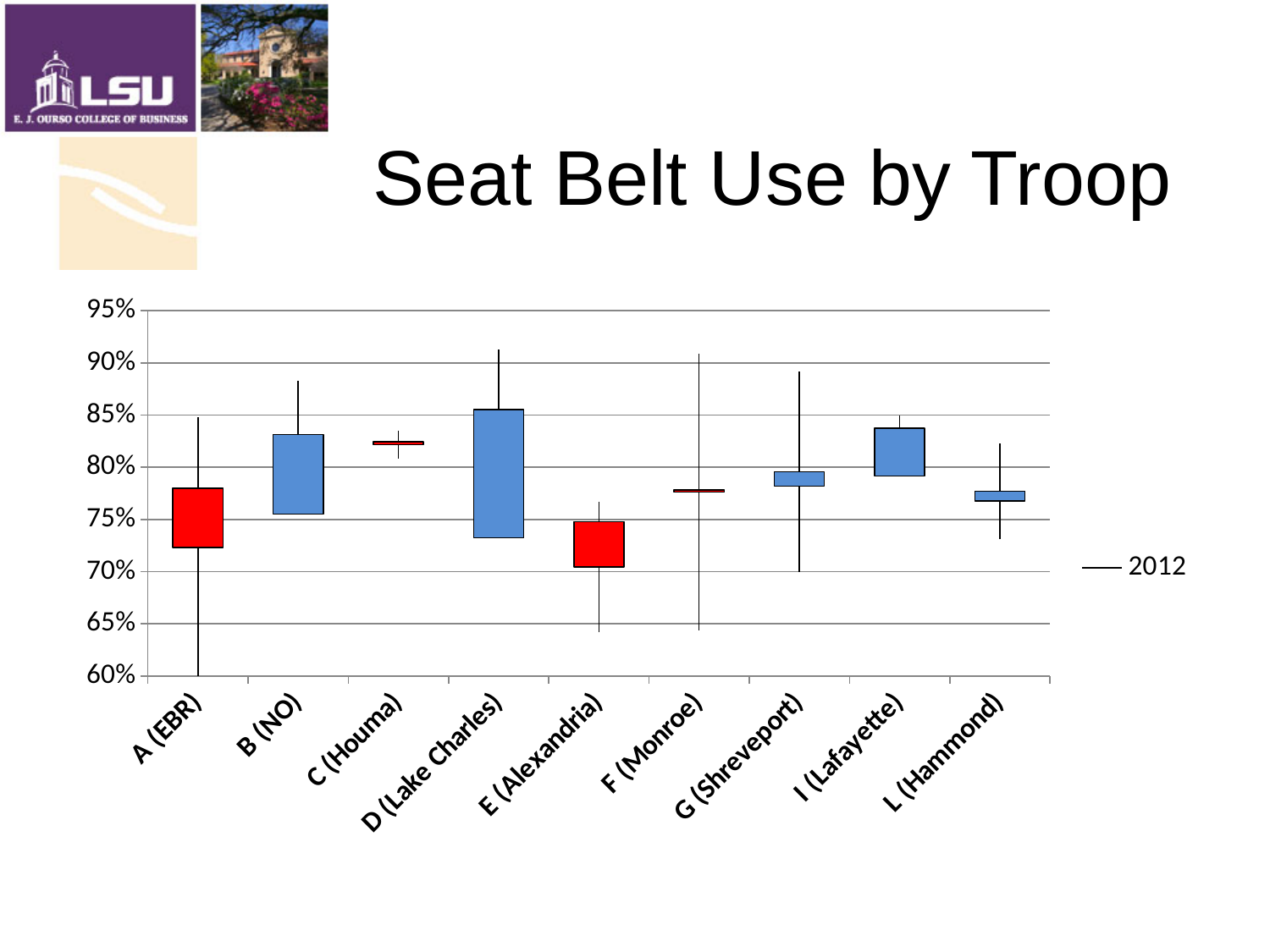
How many troops are shown along the x axis? 9 Which troop has the tallest box (widest range between box top and bottom)? D (Lake Charles) Is the lowest point of the line for A (EBR) greater or less than 65%? less Is the top of the box for E (Alexandria) greater or less than 80%? less Which troop has the taller box, D (Lake Charles) or C (Houma)? D (Lake Charles) What is the title of the chart? Seat Belt Use by Troop What year does the legend entry show? 2012 Is the bottom of the box for B (NO) greater or less than 70%? greater Which troop's lower line reaches the lowest value on the chart? A (EBR) What kind of chart is shown on the slide? candlestick (stock) chart How many series does the legend list? 1